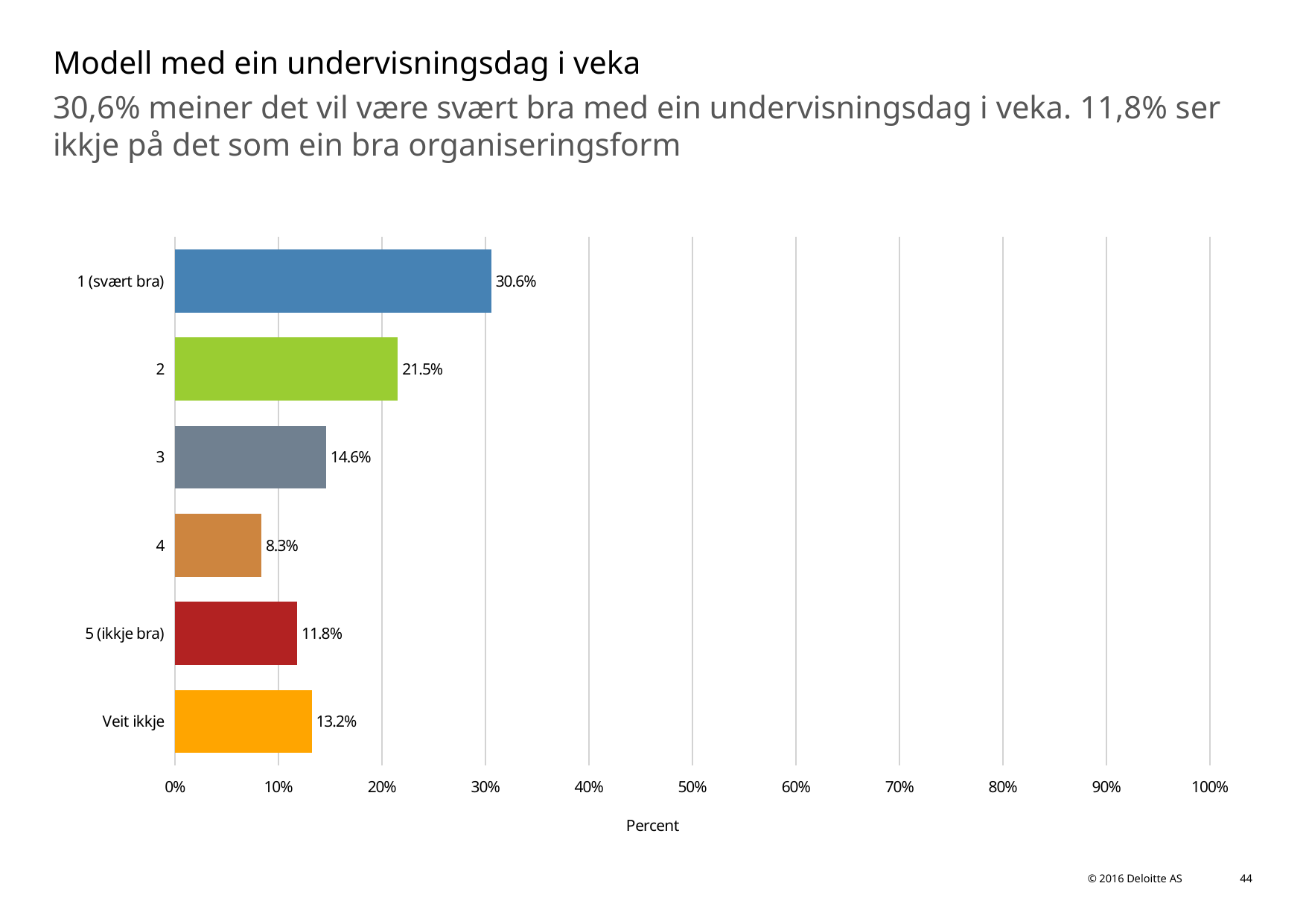
Which category has the lowest value? 4 What is the difference between the values for "2" and "3"? 6.9% Which is larger, the value for "Veit ikkje" or the value for "5 (ikkje bra)"? Veit ikkje What is the label of the horizontal axis? Percent Is the value for "2" greater or less than 20%? greater What is the value for "1 (svært bra)"? 30.6% What kind of chart is shown on the slide? bar chart What is the value for "Veit ikkje"? 13.2% What is the difference between the values for "1 (svært bra)" and "5 (ikkje bra)"? 18.8% How many categories are shown in the chart? 6 What is the value for category "4"? 8.3% Which category has the highest value? 1 (svært bra)